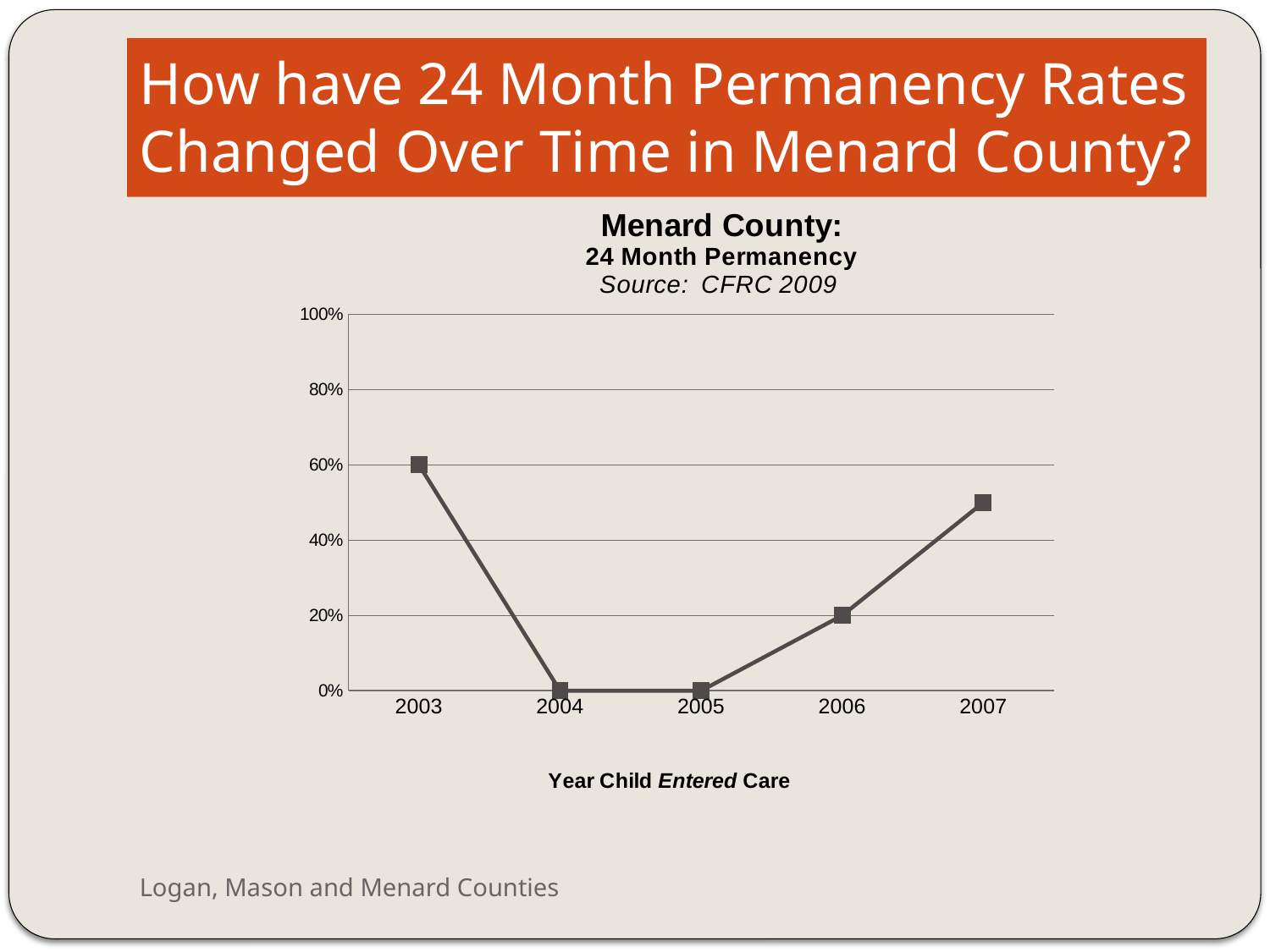
What is the difference between the permanency rates for 2003 and 2006? 40% Which years have the lowest 24 month permanency rate? 2004 and 2005 What is the 24 month permanency rate for children who entered care in 2003? 60% What is the 24 month permanency rate for 2004? 0% Do the values rise or fall from 2005 to 2007? rise What kind of chart is shown on the slide? line chart Which year has the larger permanency rate, 2003 or 2007? 2003 Is the value for 2007 greater or less than 40%? greater How many years are plotted on the chart? 5 Is the value for 2007 greater or less than 60%? less Which year has the highest 24 month permanency rate? 2003 What is the 24 month permanency rate for 2006? 20%